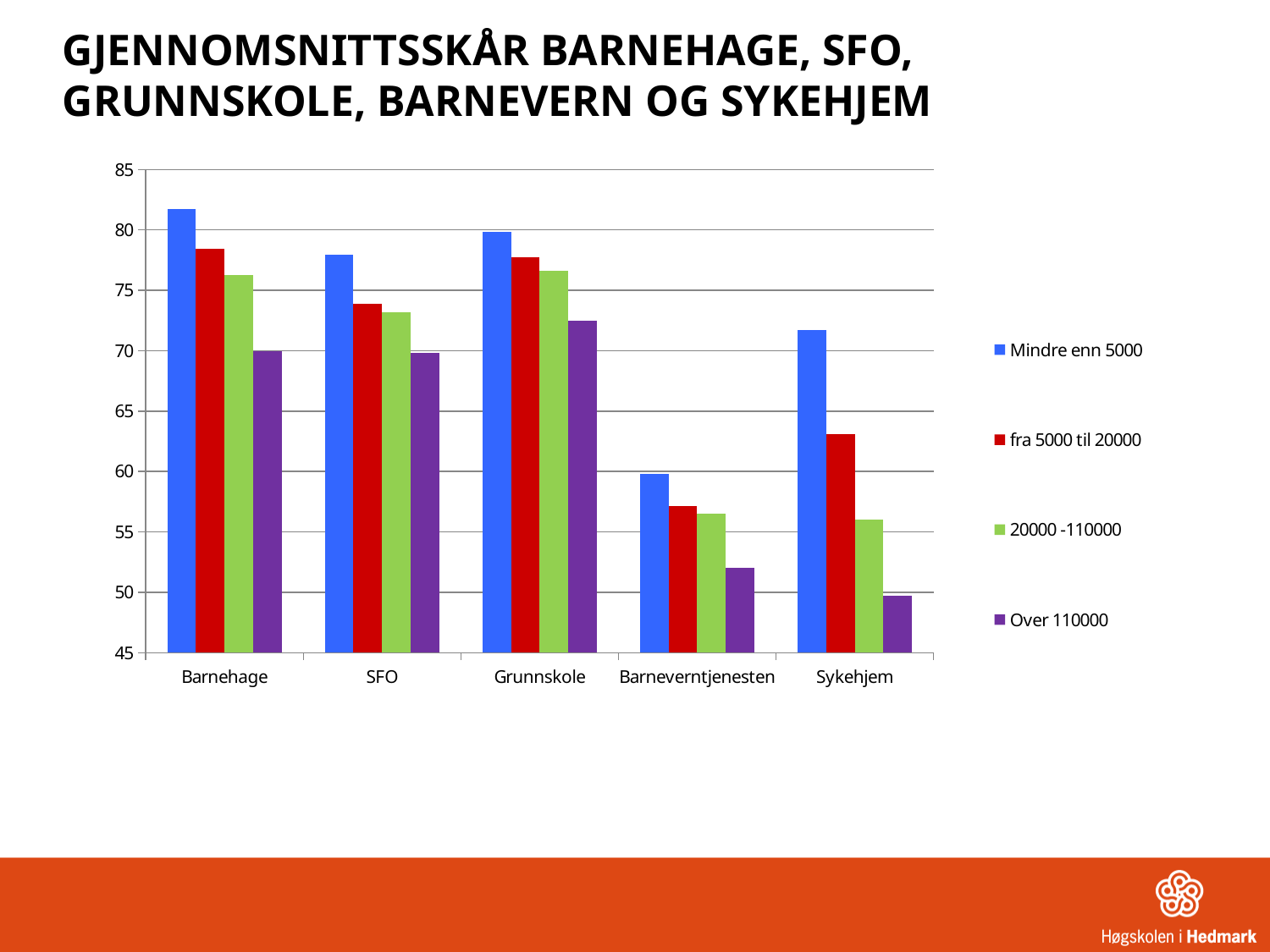
Which category has the highest value for the 'Mindre enn 5000' series? Barnehage What kind of chart is shown on the slide? bar chart Is the '20000 -110000' value for Barneverntjenesten greater or less than 60? less What colour represents the 'Over 110000' series? purple Is the 'Mindre enn 5000' value for Barnehage greater or less than 80? greater Which category has the lowest value for the 'Mindre enn 5000' series? Barneverntjenesten How many categories are shown on the x axis? 5 Is the 'Over 110000' value for Grunnskole greater or less than 70? greater Which category has the lowest value for the 'Over 110000' series? Sykehjem How many series does the legend list? 4 For Sykehjem, which is larger: the 'Mindre enn 5000' value or the 'fra 5000 til 20000' value? Mindre enn 5000 Within the Sykehjem category, do the bars rise or fall going from 'Mindre enn 5000' to 'Over 110000'? fall